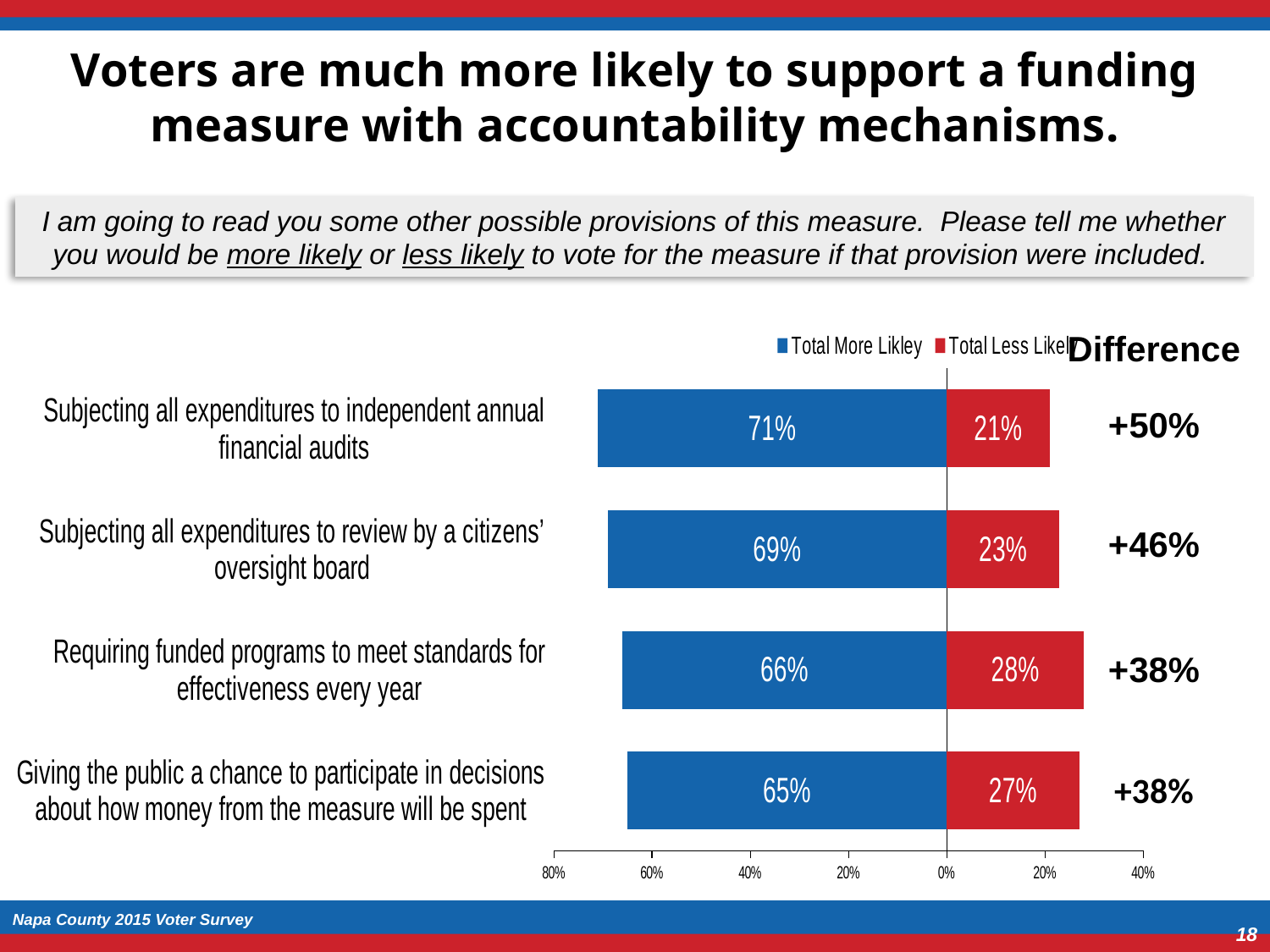
Which colour represents the Total Less Likely series? Red How many series does the legend list? 2 What is the Difference value shown for the independent annual financial audits provision? +50% What is the difference between the Total More Likely and Total Less Likely values for subjecting all expenditures to review by a citizens' oversight board? 46% Which is larger: the Total More Likely value for the citizens' oversight board provision or for the effectiveness standards provision? Citizens' oversight board (69%) What kind of chart is shown on the slide? Bar chart Which provision has the highest Total More Likely percentage? Subjecting all expenditures to independent annual financial audits How many provisions are shown in the chart? 4 What percentage of voters said they would be more likely to vote for the measure if it included subjecting all expenditures to independent annual financial audits? 71% What is the Total Less Likely value for requiring funded programs to meet standards for effectiveness every year? 28% What is the Total More Likely value for giving the public a chance to participate in decisions about how money from the measure will be spent? 65% Which provision has the lowest Total Less Likely percentage? Subjecting all expenditures to independent annual financial audits